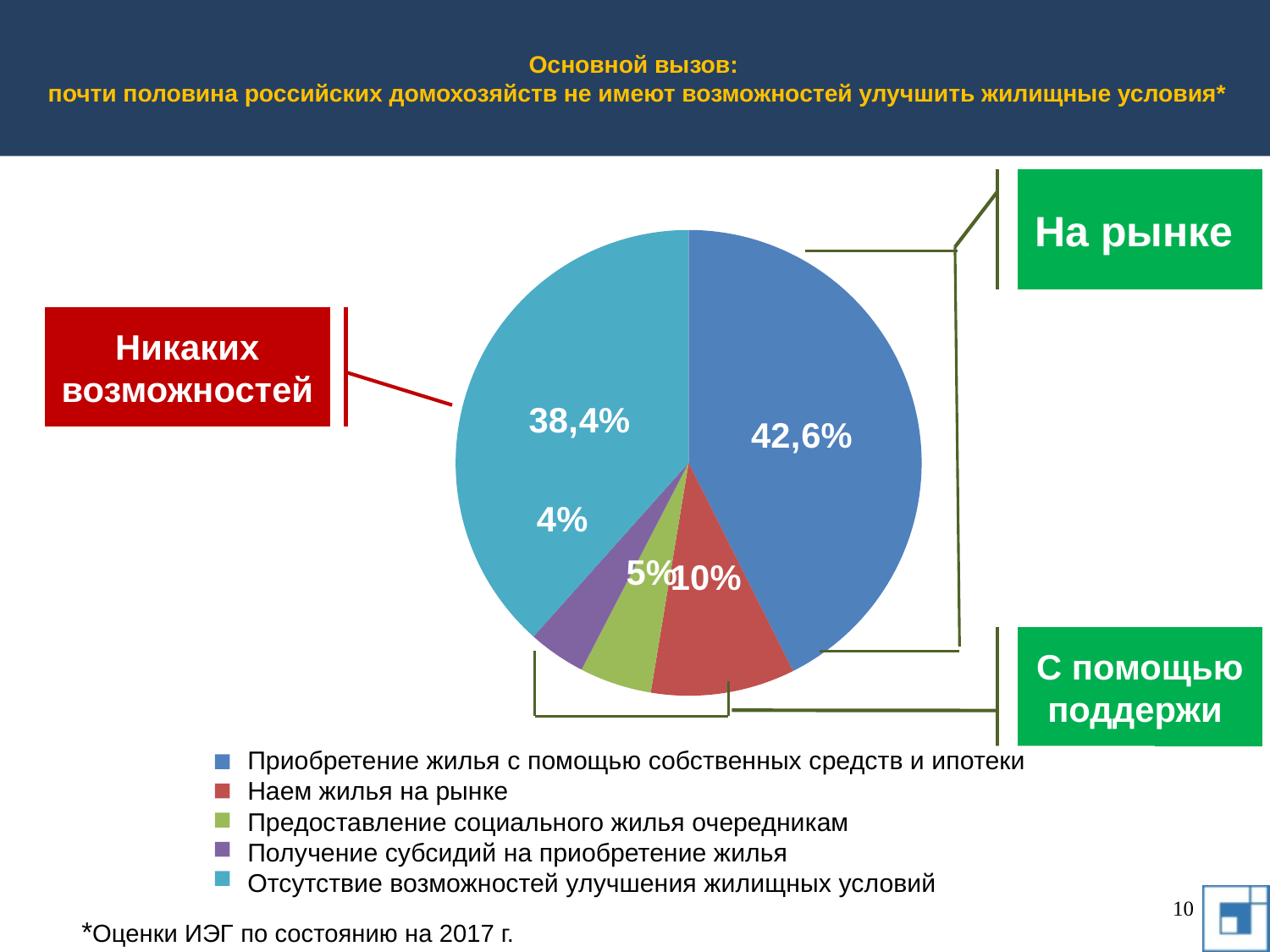
What value is shown for 'Получение субсидий на приобретение жилья'? 4% Which category has the largest slice of the pie? Приобретение жилья с помощью собственных средств и ипотеки What kind of chart is shown on the slide? pie chart How many entries does the legend list? 5 What share of the pie is labelled for 'Приобретение жилья с помощью собственных средств и ипотеки'? 42,6% Which is larger: the slice for 'Наем жилья на рынке' or the slice for 'Предоставление социального жилья очередникам'? Наем жилья на рынке What is the difference between the 'Приобретение жилья с помощью собственных средств и ипотеки' slice and the 'Отсутствие возможностей улучшения жилищных условий' slice? 4,2% Which category has the smallest slice of the pie? Получение субсидий на приобретение жилья How many slices does the pie chart have? 5 What colour is the slice for 'Отсутствие возможностей улучшения жилищных условий'? light blue (cyan) What value is shown for 'Наем жилья на рынке'? 10% What value is shown for 'Отсутствие возможностей улучшения жилищных условий'? 38,4%